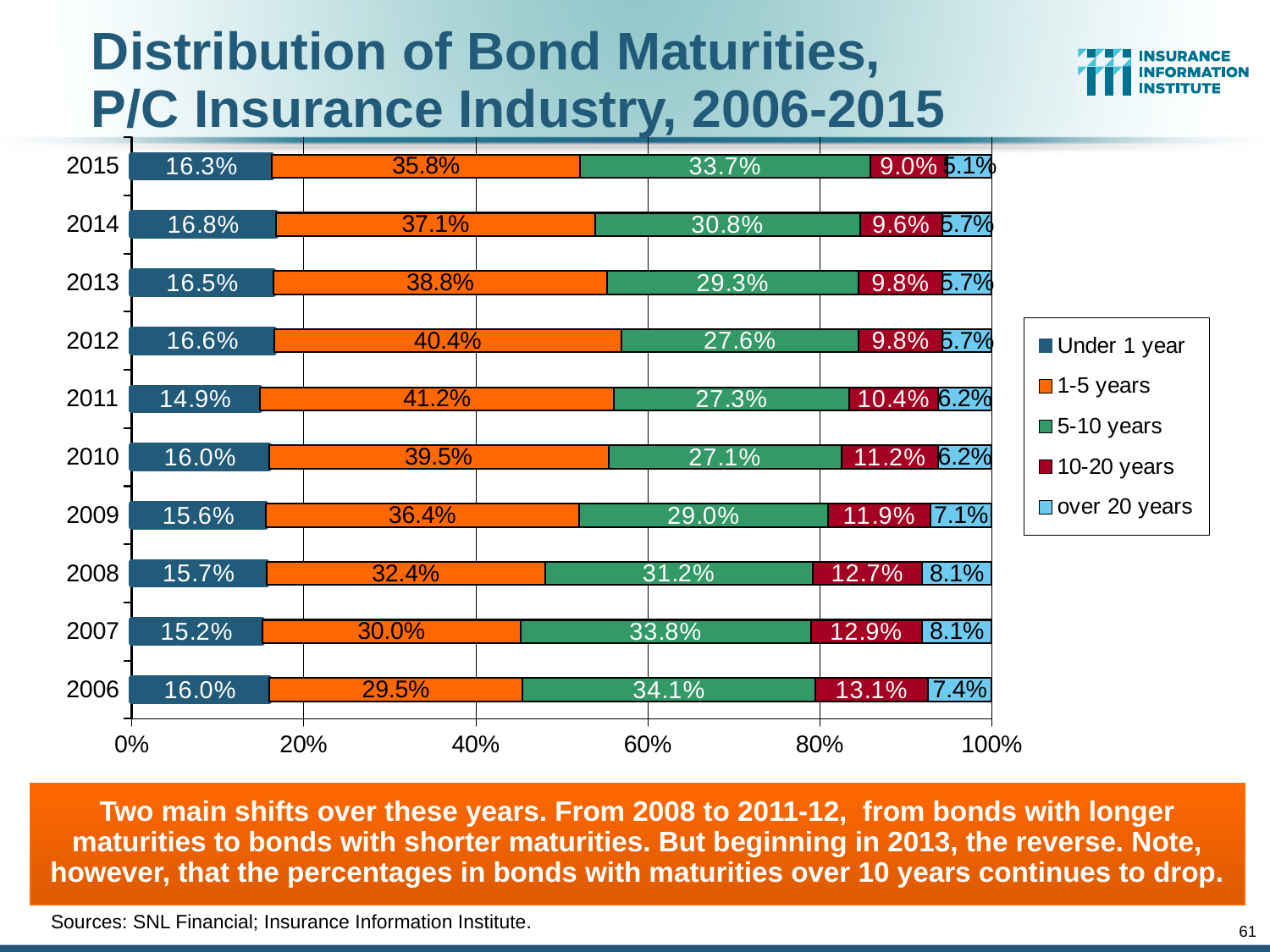
What percentage of bonds had maturities of 1-5 years in 2012? 40.4% How many percentage points higher was the 1-5 years share in 2015 than in 2006? 6.3 percentage points Did the 10-20 years share rise or fall from 2006 to 2015? Fall What share of bonds had 5-10 year maturities in 2006? 34.1% What was the over 20 years share in 2008? 8.1% In which year was the 1-5 years share the highest? 2011 What was the 10-20 years share in 2009? 11.9% How many maturity categories does the legend list? 5 How many years are shown on the chart? 10 What kind of chart is shown on the slide? Stacked bar chart In which year was the Under 1 year share the lowest? 2011 Which year had a larger 5-10 years share, 2015 or 2014? 2015